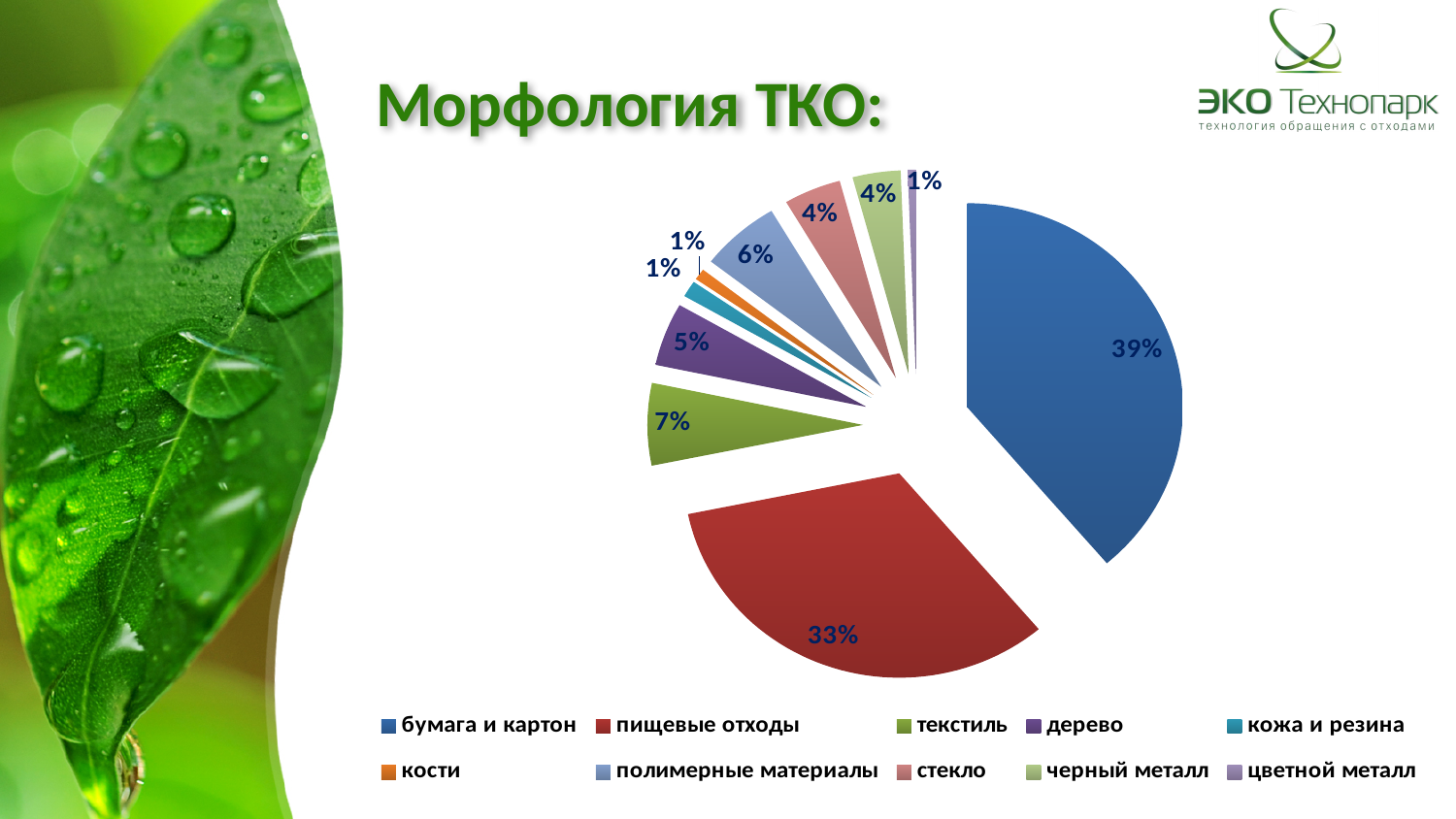
What is the share of бумага и картон in the pie chart? 39% What is the title of the chart on the slide? Морфология ТКО: What is the share of стекло in the pie chart? 4% What is the share of полимерные материалы in the pie chart? 6% What type of chart is shown on the slide? pie chart Which category has the largest share in the pie chart? бумага и картон Which has a larger share, текстиль or полимерные материалы? текстиль What is the share of дерево in the pie chart? 5% What is the share of пищевые отходы in the pie chart? 33% What is the share of текстиль in the pie chart? 7% What is the difference in percentage points between бумага и картон and пищевые отходы? 6 How many categories does the legend of the pie chart list? 10